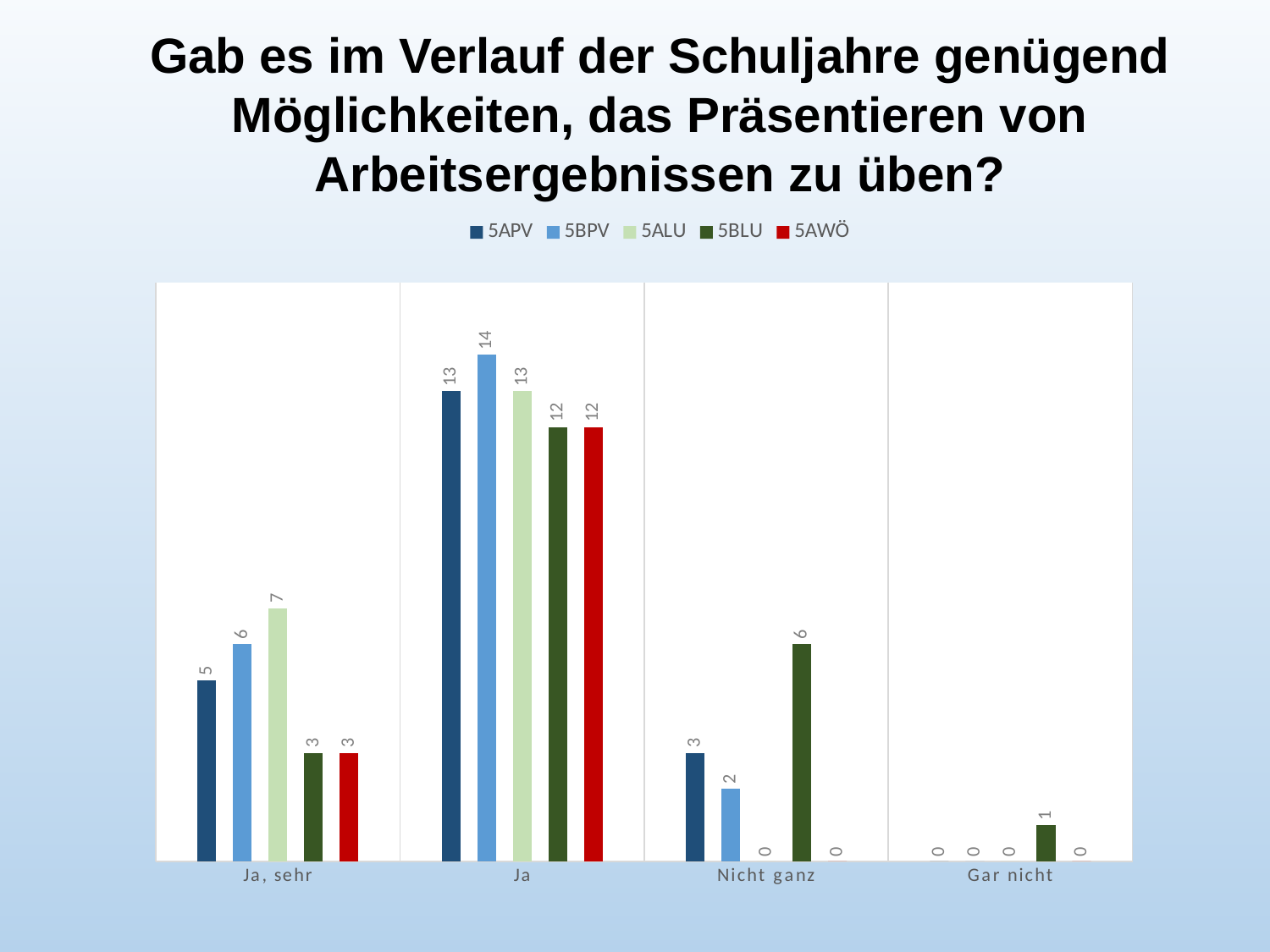
What is the total of the 5APV values across all four categories? 21 Which is larger in the "Nicht ganz" category: 5APV or 5BPV? 5APV What is the difference between the 5BPV and 5AWÖ values in the "Ja" category? 2 Which series has the highest value in the "Ja" category? 5BPV What value does 5BLU have for the category "Nicht ganz"? 6 What kind of chart is shown on the slide? Bar chart What value does 5ALU have for the category "Ja, sehr"? 7 Which series is the only one with a non-zero value in the "Gar nicht" category? 5BLU How many categories are shown on the x axis? 4 What value does 5BPV have for the category "Ja"? 14 Which series has the highest value in the "Ja, sehr" category? 5ALU How many series does the legend list? 5